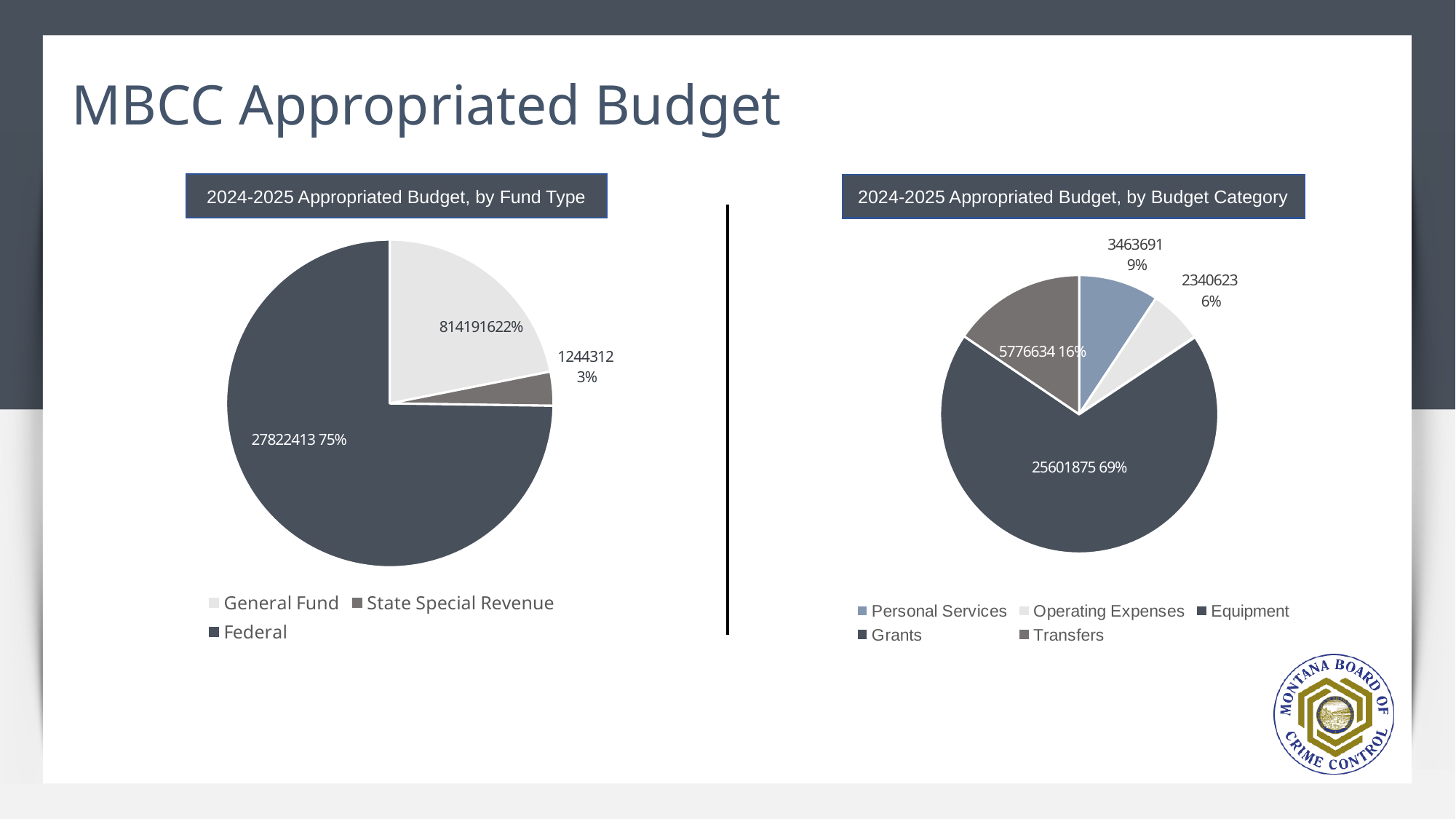
In the '2024-2025 Appropriated Budget, by Budget Category' chart, what is the value for Grants? 25601875 In the '2024-2025 Appropriated Budget, by Budget Category' chart, what share of the pie is Transfers? 16% In the '2024-2025 Appropriated Budget, by Fund Type' chart, what share of the pie is Federal? 75% In the '2024-2025 Appropriated Budget, by Budget Category' chart, which is larger, Personal Services or Operating Expenses? Personal Services In the '2024-2025 Appropriated Budget, by Fund Type' chart, which fund type has the largest slice? Federal In the '2024-2025 Appropriated Budget, by Fund Type' chart, what is the value for Federal? 27822413 How many budget categories does the legend of the '2024-2025 Appropriated Budget, by Budget Category' chart list? 5 How many fund types does the legend of the '2024-2025 Appropriated Budget, by Fund Type' chart list? 3 In the '2024-2025 Appropriated Budget, by Budget Category' chart, what is the value for Personal Services? 3463691 In the '2024-2025 Appropriated Budget, by Fund Type' chart, what is the value for State Special Revenue? 1244312 What type of chart is used on the left, '2024-2025 Appropriated Budget, by Fund Type'? Pie chart In the '2024-2025 Appropriated Budget, by Fund Type' chart, what share of the pie is State Special Revenue? 3%